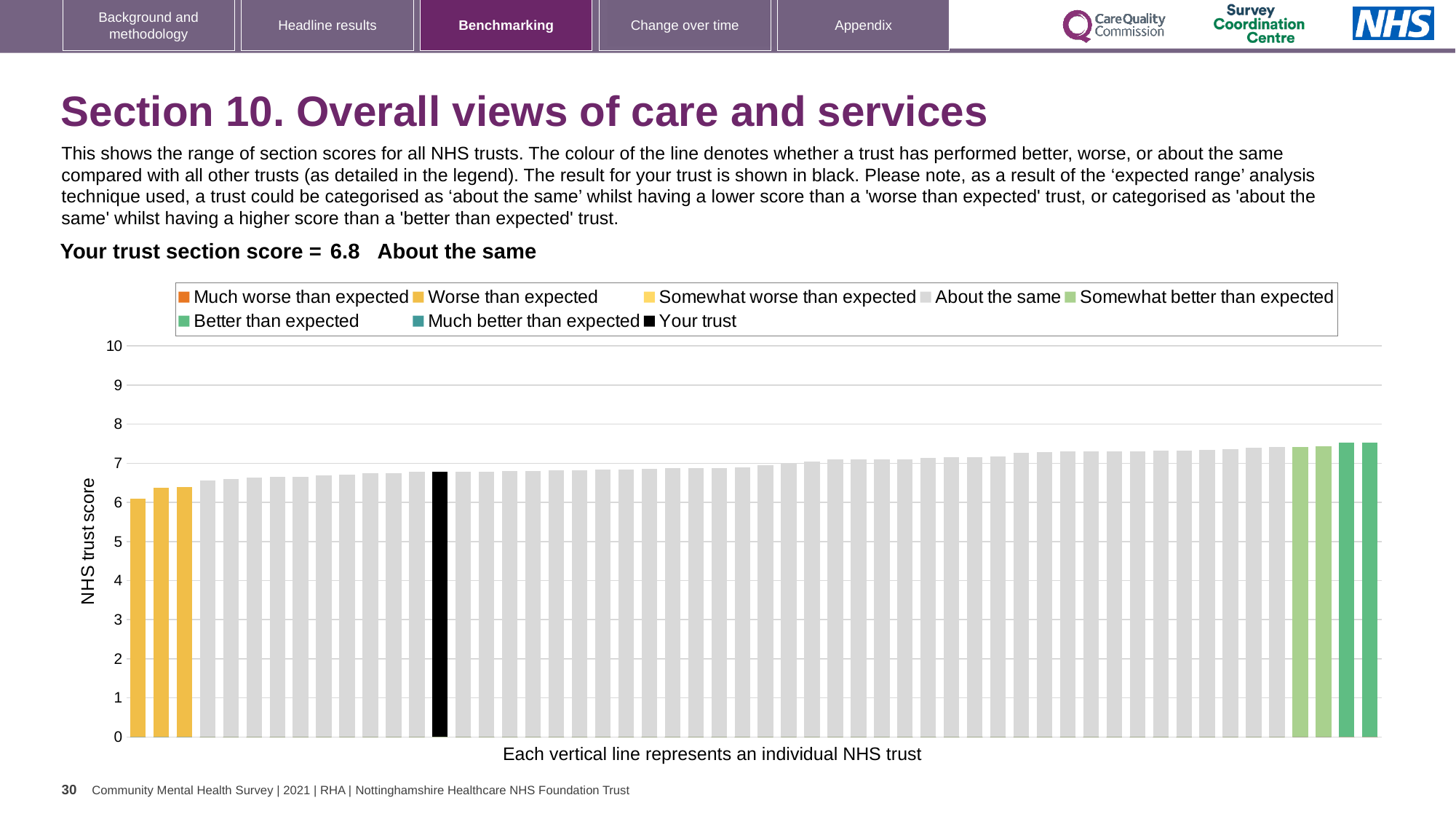
Do the bar values rise or fall from left to right along the x axis? Rise What is the label on the y axis of the chart? NHS trust score Is the value for your trust greater or less than 5? greater What colour is the bar representing your trust? Black How many bars are coloured as 'Worse than expected'? 3 How many bars are coloured as 'Better than expected'? 2 Which category is your trust placed in for this section? About the same Is the highest bar in the chart greater or less than 8? less How many entries does the chart legend list? 8 What kind of chart is shown on the slide? Bar chart What is the section score for your trust? 6.8 Is the lowest bar in the chart greater or less than 5? greater